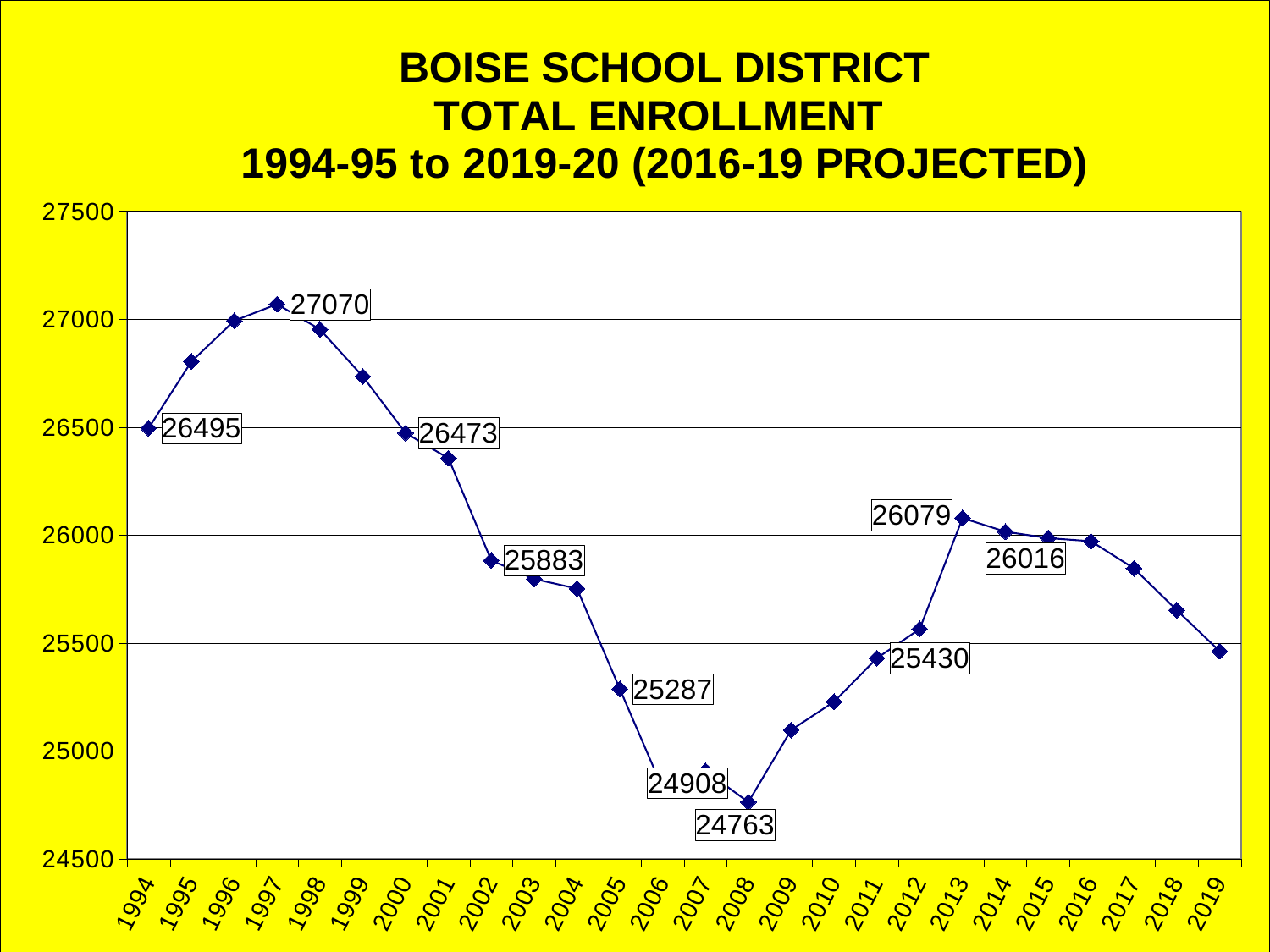
Is the enrollment value for 1996 greater or less than 26500? greater Which is larger, the enrollment in 2002 or the enrollment in 2005? 2002 Which year has the highest enrollment? 1997 Which year has the lowest enrollment? 2008 How many years are plotted on the x axis? 26 What was the total enrollment in 1994? 26495 What was the total enrollment in 2008? 24763 What is the difference between the enrollment in 1997 and the enrollment in 2008? 2307 What is the difference between the enrollment in 2013 and the enrollment in 2011? 649 What type of chart is shown on the slide? line chart What was the total enrollment in 2011? 25430